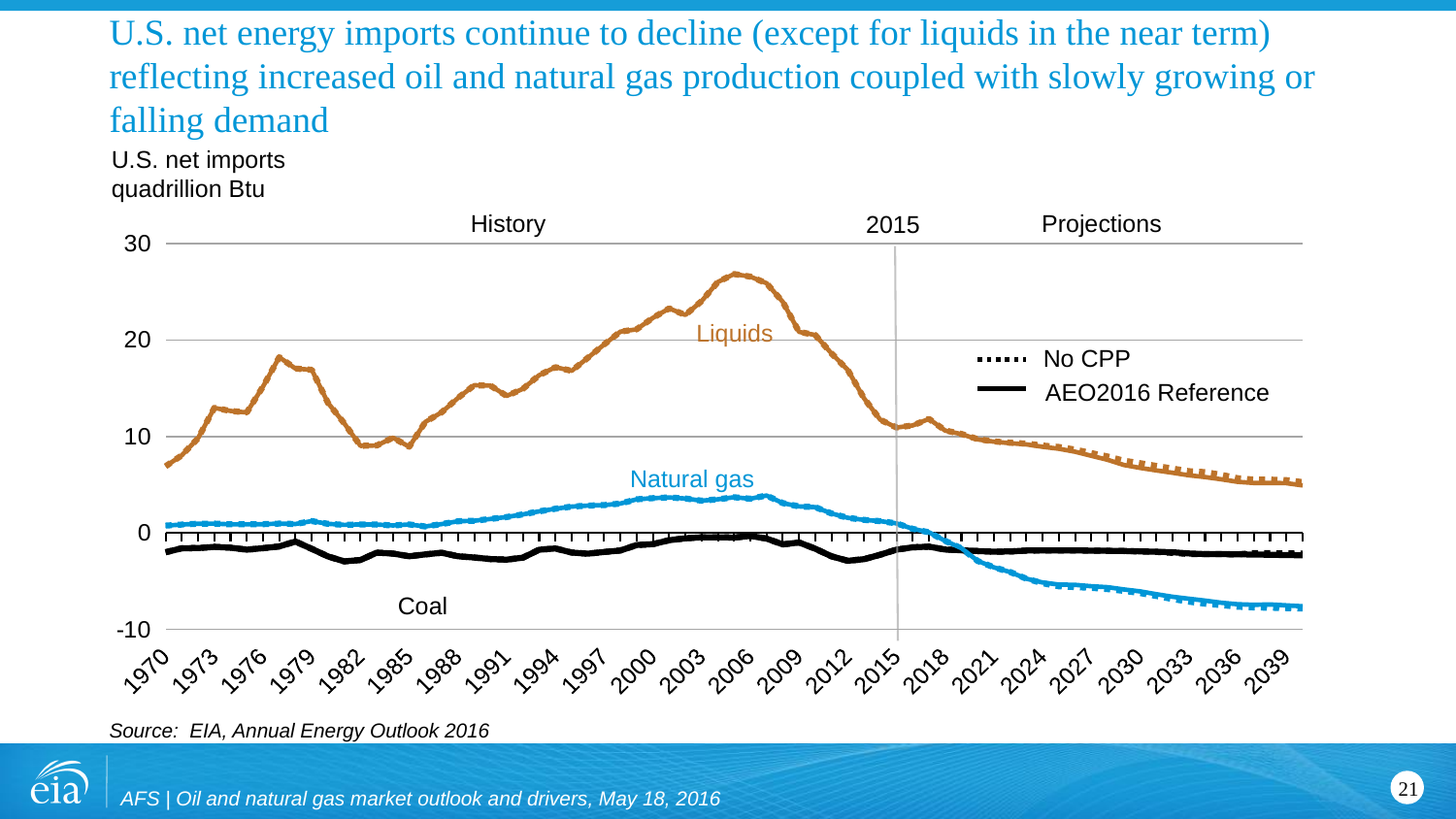
Is the value for Liquids in 2006 greater or less than 20? greater Is the value for Natural gas in 2039 greater or less than 0? less Which line style does the legend use for the No CPP case? dotted In 2039, which is larger: the value for Coal or the value for Natural gas? Coal Is the value for Liquids in 1979 greater or less than 10? greater What kind of chart is shown on the slide? line chart Which series has the lowest value in 2039? Natural gas Which series has the highest value in 2006? Liquids Do the Liquids values rise or fall from 2015 to 2039? fall What unit is used for the y axis of the chart? quadrillion Btu How many entries does the legend list? 2